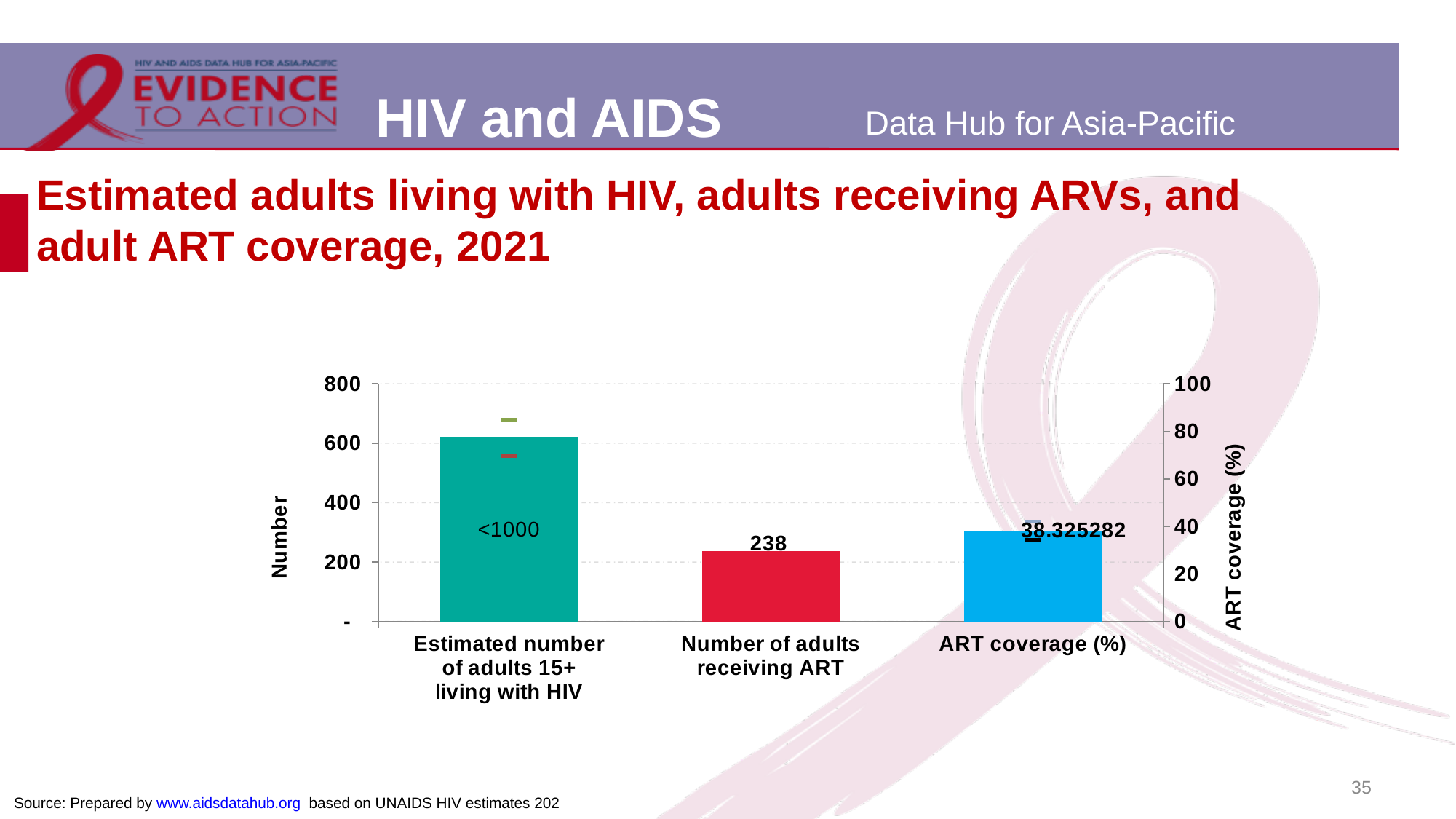
What is the maximum value shown on the right vertical axis (ART coverage (%))? 100 Which category has the shortest bar in the chart? Number of adults receiving ART How many categories are shown on the x axis of the chart? 3 Which category has the tallest bar in the chart? Estimated number of adults 15+ living with HIV What is the value shown for ART coverage (%)? 38.325282 Is the value for ART coverage (%) greater or less than 40 on the right axis? less What is the value shown for Number of adults receiving ART? 238 What kind of chart is shown on the slide? Bar chart What is the title of the left vertical axis? Number Is the value for Number of adults receiving ART greater or less than 200? greater Is the bar for Estimated number of adults 15+ living with HIV greater or less than 400 on the left axis? greater What label is printed on the bar for Estimated number of adults 15+ living with HIV? <1000